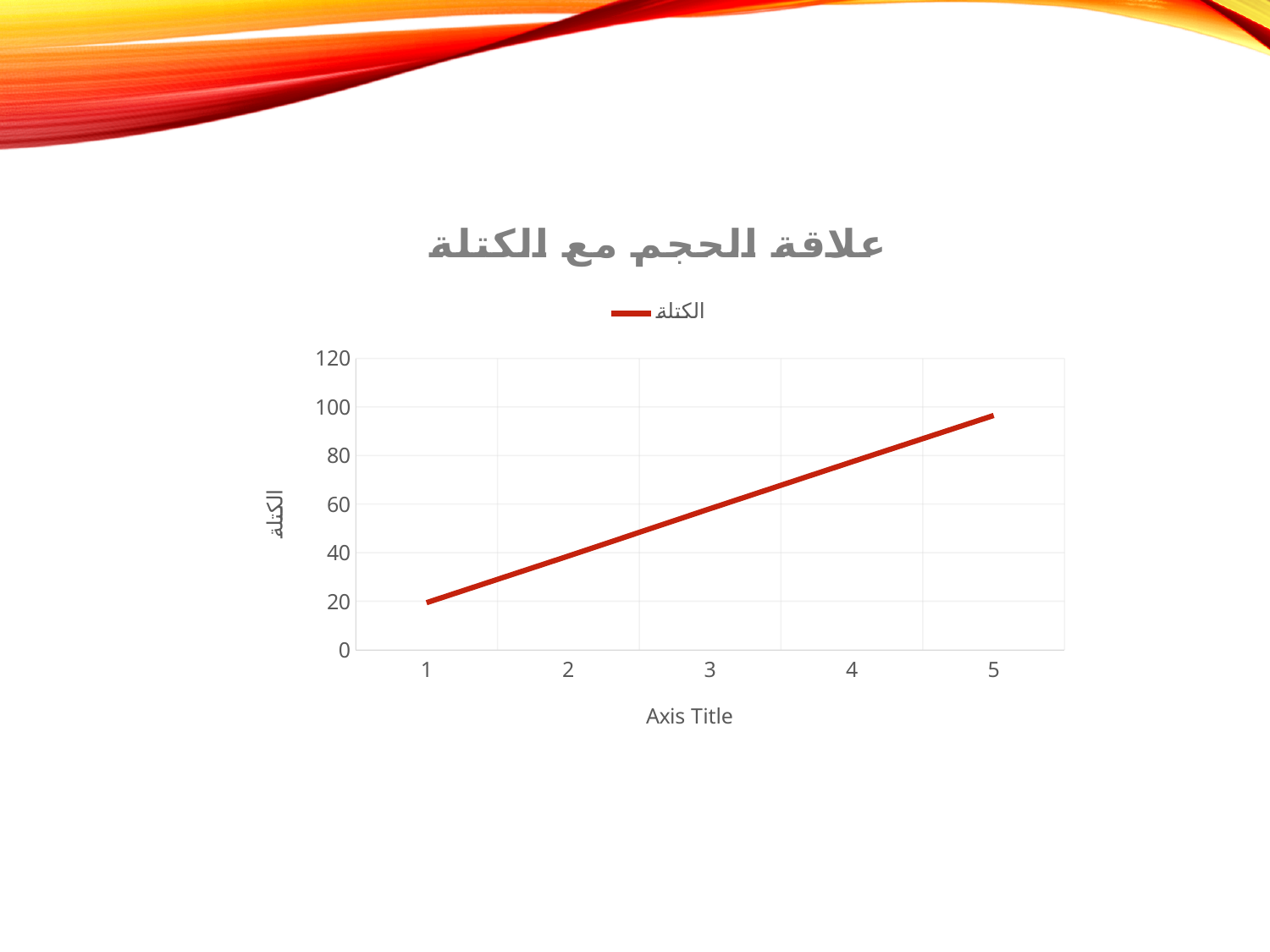
Do the values rise or fall as the x axis goes from 1 to 5? rise At which x-axis category is the value highest? 5 How many data points are plotted on the line? 5 At which x-axis category is the value lowest? 1 What kind of chart is shown on the slide? line chart Is the value at x = 5 greater or less than 80? greater How many series does the legend list? 1 What is the title of the chart? علاقة الحجم مع الكتلة Which has the larger value, x = 2 or x = 4? 4 What is the name of the series shown in the legend? الكتلة Is the value at x = 3 greater or less than 80? less Is the value at x = 1 greater or less than 40? less